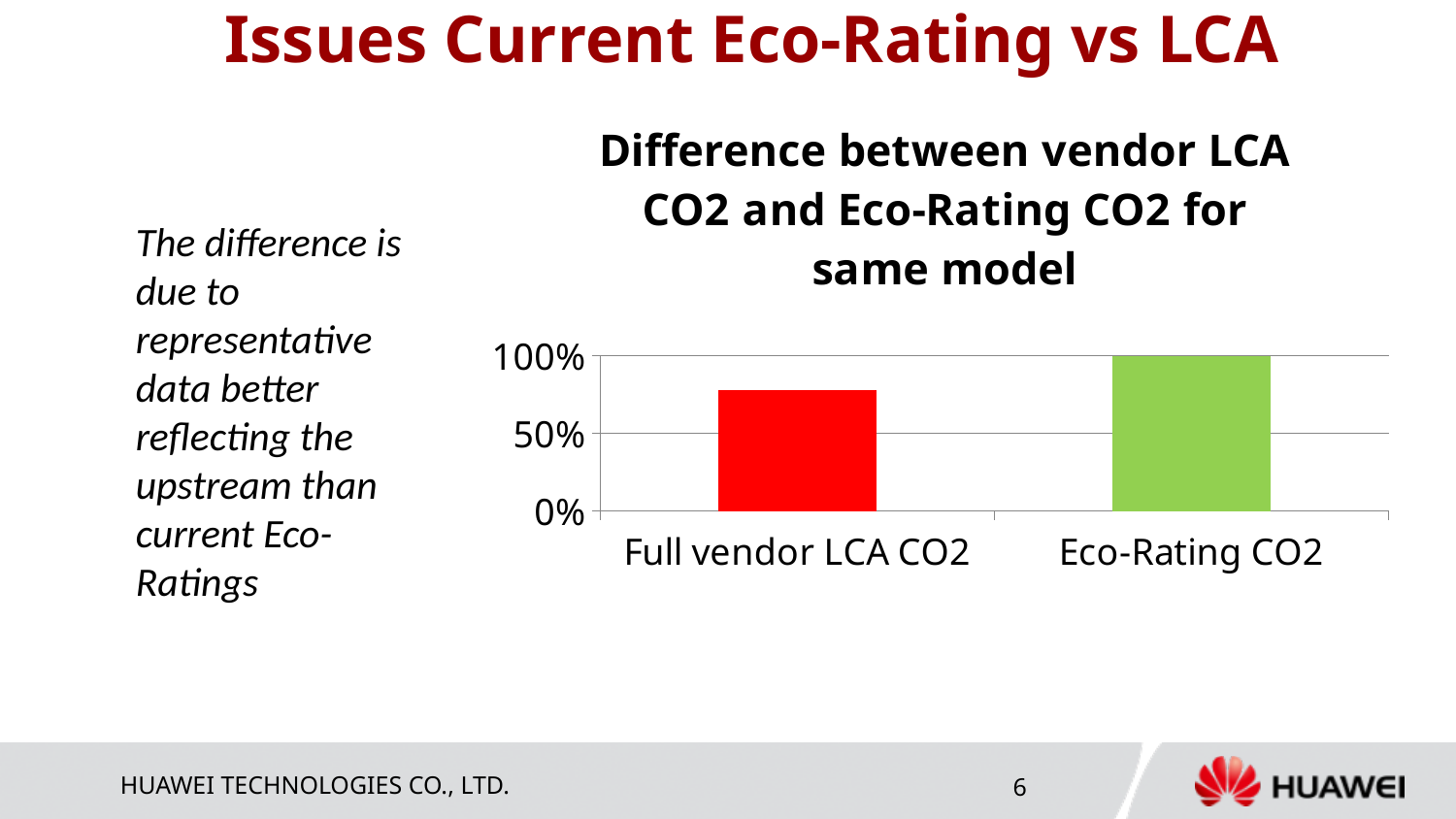
Is the value for Full vendor LCA CO2 greater or less than 100%? less What colour is the bar for Full vendor LCA CO2? red Which category has the lowest value in the chart? Full vendor LCA CO2 What is the title of the chart? Difference between vendor LCA CO2 and Eco-Rating CO2 for same model What kind of chart is shown on the slide? bar chart Is the value for Full vendor LCA CO2 greater or less than 50%? greater How many categories are plotted in the chart? 2 Which category has the highest value in the chart? Eco-Rating CO2 What value does the Eco-Rating CO2 bar reach on the axis? 100% Which is larger, the value for Full vendor LCA CO2 or the value for Eco-Rating CO2? Eco-Rating CO2